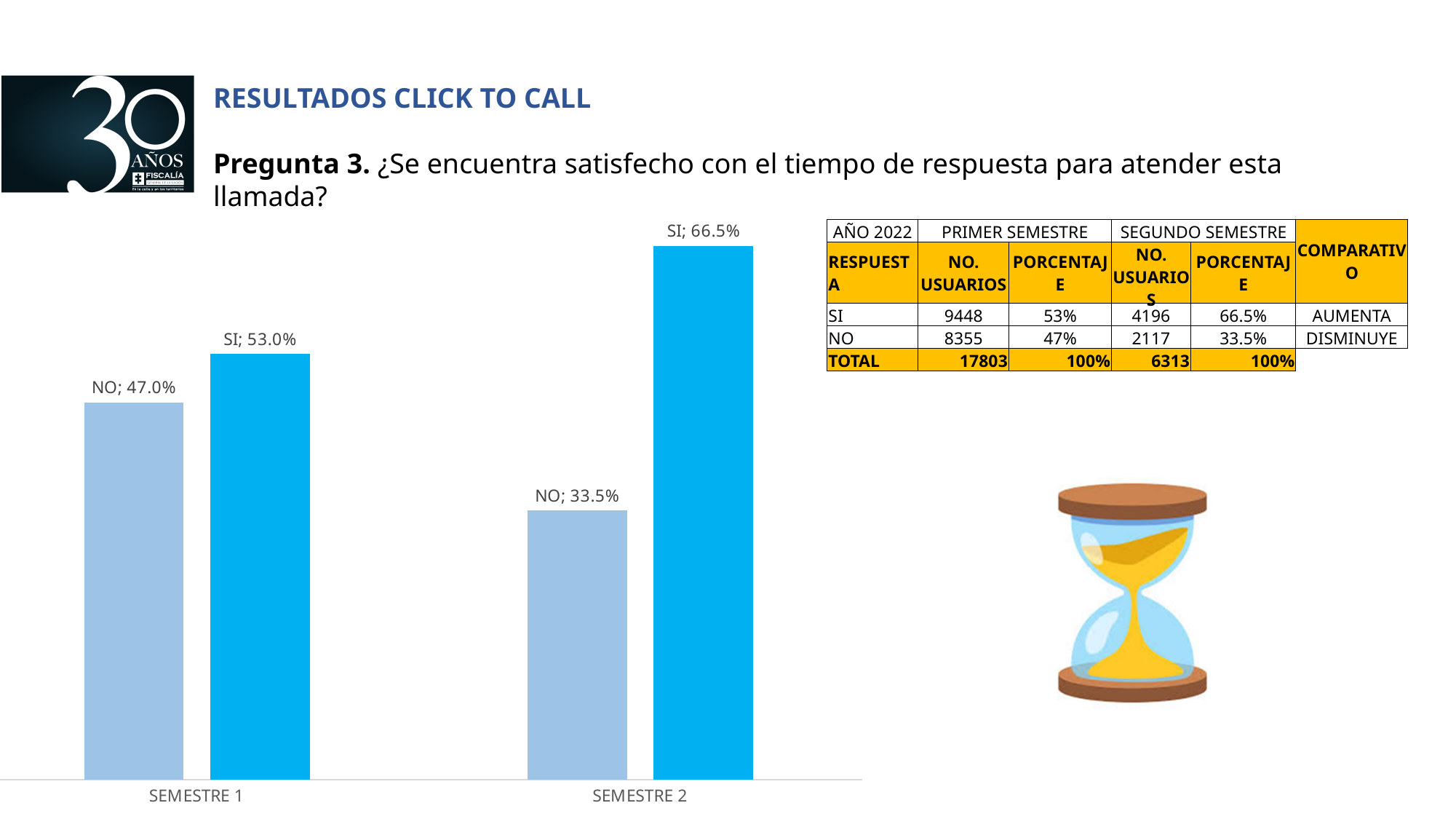
What kind of chart is shown on the slide? Bar chart What is the difference between the SI and NO values for SEMESTRE 1? 6.0% Which is larger for SEMESTRE 2, the SI bar or the NO bar? SI How many categories are shown on the x axis of the chart? 2 What is the difference between the SI values for SEMESTRE 2 and SEMESTRE 1? 13.5% What is the value of the NO bar for SEMESTRE 1? 47.0% Which bar in the chart has the lowest value? NO for SEMESTRE 2 What is the value of the NO bar for SEMESTRE 2? 33.5% Does the NO value rise or fall from SEMESTRE 1 to SEMESTRE 2? Fall What is the value of the SI bar for SEMESTRE 2? 66.5% What is the value of the SI bar for SEMESTRE 1? 53.0% Which bar in the chart has the highest value? SI for SEMESTRE 2